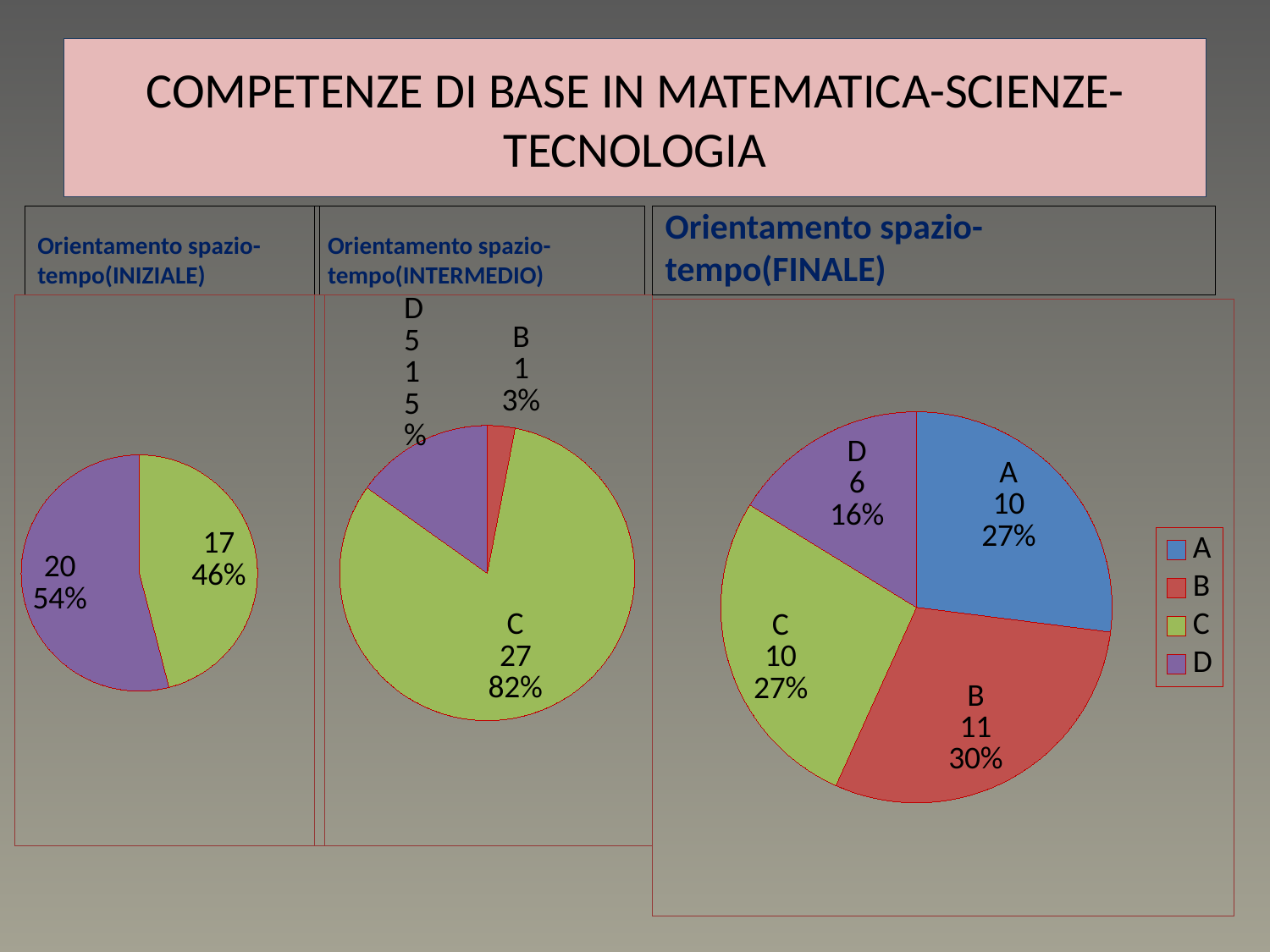
In the Orientamento spazio-tempo(FINALE) chart, what percentage is shown for category D? 16% In the Orientamento spazio-tempo(FINALE) chart, which category has the largest slice? B In the Orientamento spazio-tempo(FINALE) chart, what is the difference between the values for B and D? 5 In the Orientamento spazio-tempo(INIZIALE) chart, which slice is larger, the green one or the purple one? the purple one What kind of chart is used for Orientamento spazio-tempo(INIZIALE)? pie chart In the Orientamento spazio-tempo(INTERMEDIO) chart, what percentage is shown for category B? 3% In the Orientamento spazio-tempo(INTERMEDIO) chart, which category has the largest slice? C How many categories does the legend of the Orientamento spazio-tempo(FINALE) chart list? 4 In the Orientamento spazio-tempo(FINALE) chart, which category has the smallest slice? D In the Orientamento spazio-tempo(INTERMEDIO) chart, what value is shown for category C? 27 In the Orientamento spazio-tempo(FINALE) chart, what value is shown for category B? 11 In the Orientamento spazio-tempo(INIZIALE) chart, what percentage is shown for the purple slice? 54%